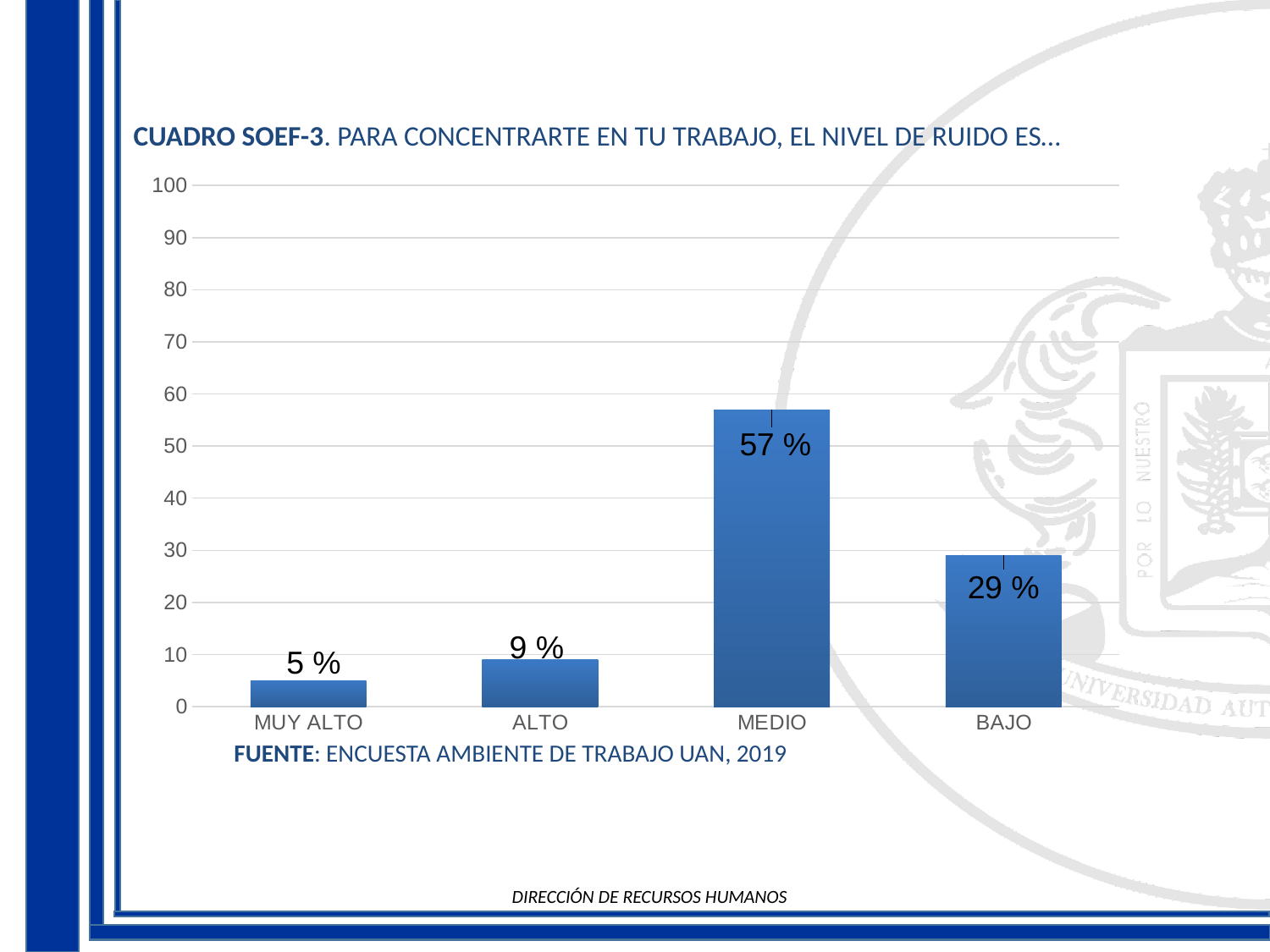
Which category has the lowest value? MUY ALTO Which category has the highest value? MEDIO What is the value for ALTO? 9 % What is the value for MUY ALTO? 5 % How many categories are shown on the x axis? 4 What source is cited below the chart? ENCUESTA AMBIENTE DE TRABAJO UAN, 2019 What is the difference between the values for MEDIO and BAJO? 28 % What is the value for BAJO? 29 % Which is larger, the value for ALTO or the value for MUY ALTO? ALTO What is the value for MEDIO? 57 % What kind of chart is shown on the slide? bar chart Is the value for MEDIO greater or less than 50? greater